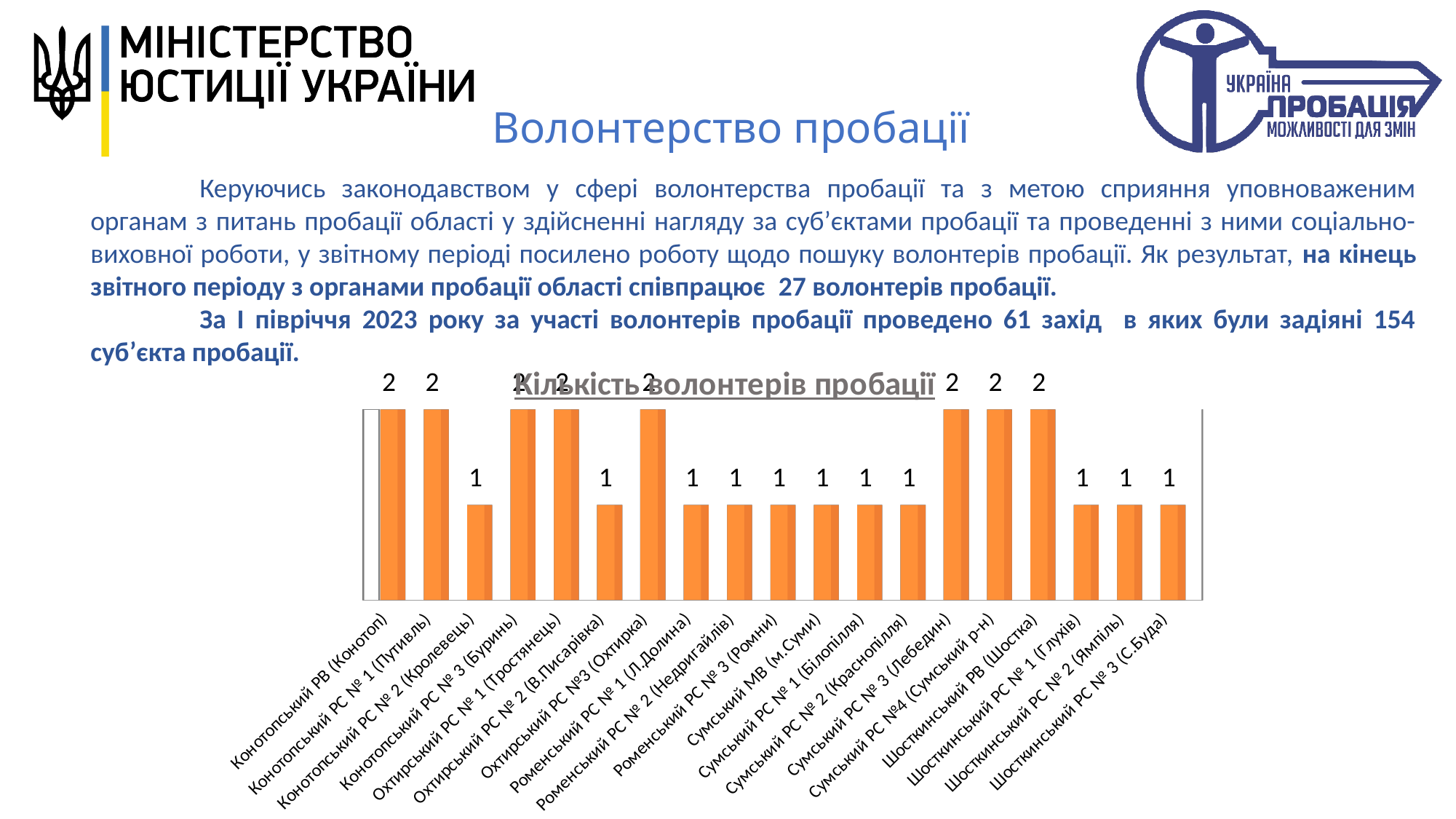
What is the value for Сумський МВ (м.Суми)? 1 Which is larger, the value for Сумський РС №4 (Сумський р-н) or the value for Сумський РС № 2 (Краснопілля)? Сумський РС №4 (Сумський р-н) What is the value for Шосткинський РВ (Шостка)? 2 What is the value for Роменський РС № 3 (Ромни)? 1 What is the value for Конотопський РС № 2 (Кролевець)? 1 What is the title of the chart? Кількість волонтерів пробації What is the value for Сумський РС № 3 (Лебедин)? 2 What kind of chart is shown on the slide? Bar chart How many categories are shown on the x axis of the chart? 19 What is the difference between the values for Конотопський РВ (Конотоп) and Шосткинський РС № 1 (Глухів)? 1 Which is larger, the value for Охтирський РС № 2 (В.Писарівка) or the value for Охтирський РС №3 (Охтирка)? Охтирський РС №3 (Охтирка) How many categories have a value of 2? 8